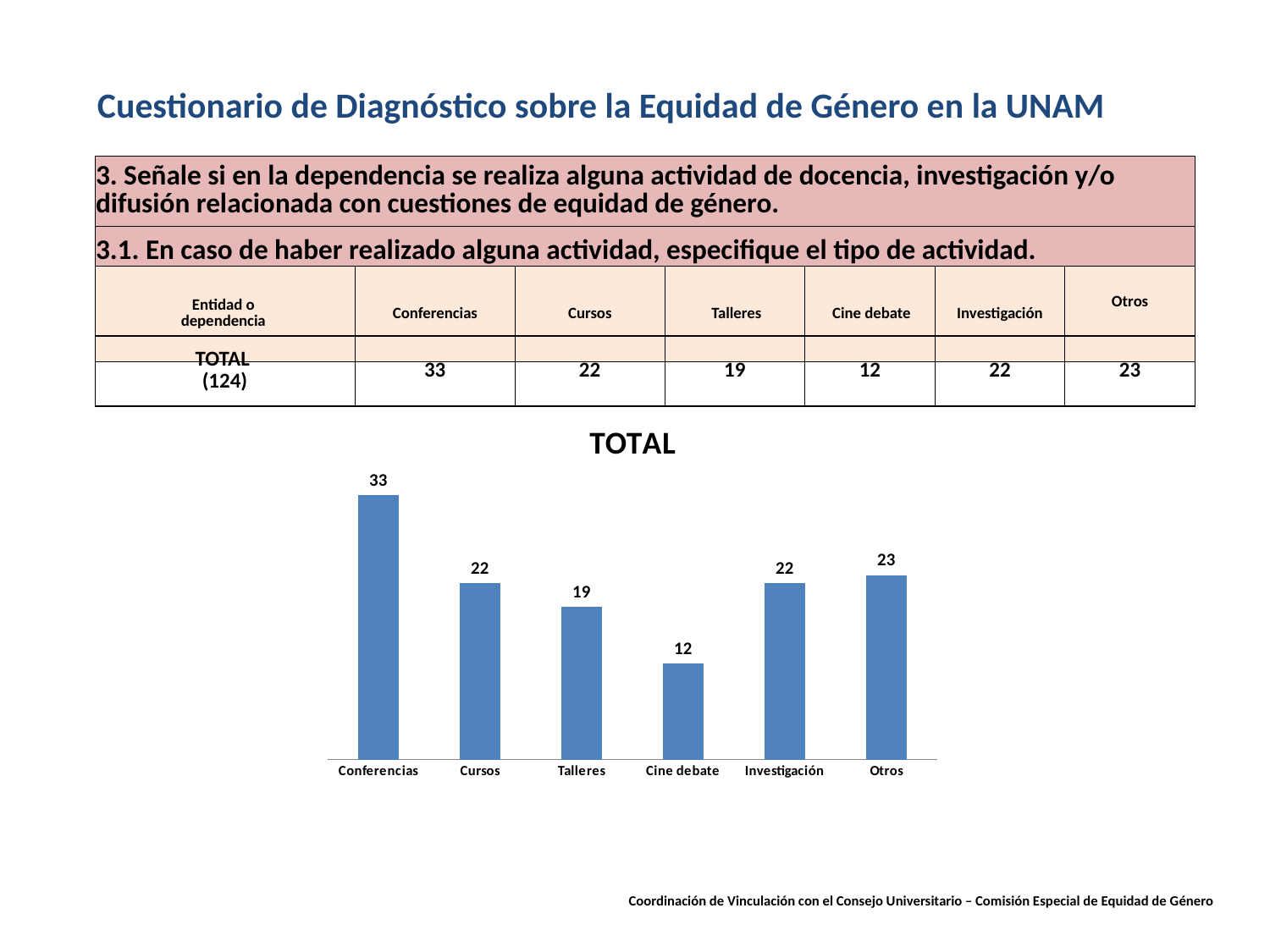
What is the value for Talleres in the TOTAL chart? 19 What is the title of the chart on the slide? TOTAL Which category has the lowest value in the TOTAL chart? Cine debate How many categories are shown in the TOTAL chart? 6 What is the value for Otros in the TOTAL chart? 23 What is the difference between the values for Conferencias and Cine debate in the TOTAL chart? 21 Which is larger in the TOTAL chart, Talleres or Investigación? Investigación What is the value for Cine debate in the TOTAL chart? 12 Which category has the highest value in the TOTAL chart? Conferencias What is the value for Conferencias in the TOTAL chart? 33 What kind of chart is the TOTAL chart? Bar chart What is the difference between the values for Otros and Talleres in the TOTAL chart? 4